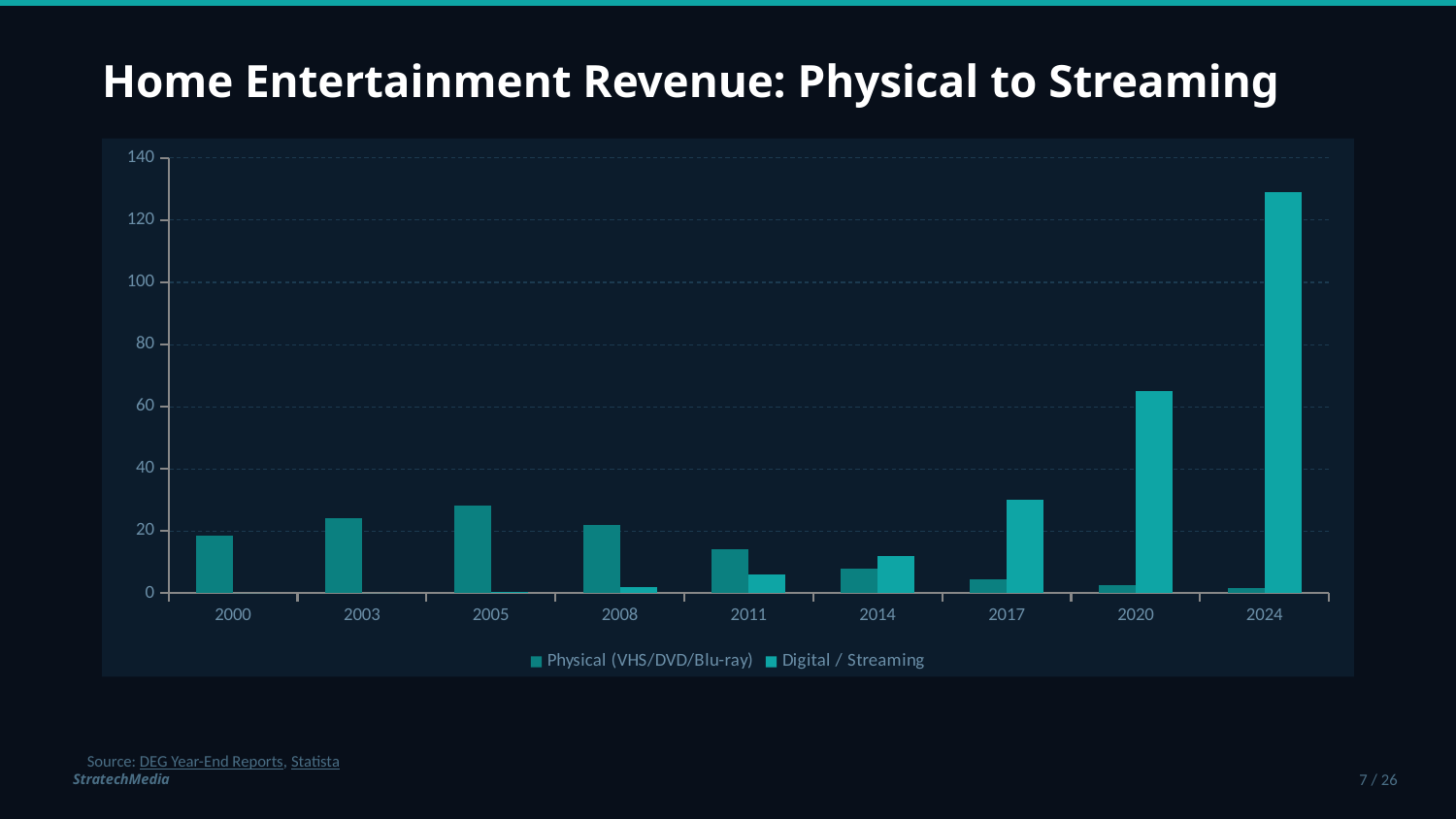
What kind of chart is shown on the slide? Bar chart Is the Digital / Streaming value for 2024 greater or less than 120? greater How many years are shown along the x axis of the chart? 9 What is the title of the chart on the slide? Home Entertainment Revenue: Physical to Streaming In 2011, which is larger: the Physical (VHS/DVD/Blu-ray) value or the Digital / Streaming value? Physical (VHS/DVD/Blu-ray) Is the Physical (VHS/DVD/Blu-ray) value for 2005 greater or less than 20? greater How many series does the chart's legend list? 2 In which year is the Digital / Streaming value highest? 2024 Does the Digital / Streaming series rise or fall from 2008 to 2024? Rise Is the Digital / Streaming value for 2020 greater or less than 80? less In which year is the Physical (VHS/DVD/Blu-ray) value highest? 2005 In 2014, which is larger: the Physical (VHS/DVD/Blu-ray) value or the Digital / Streaming value? Digital / Streaming